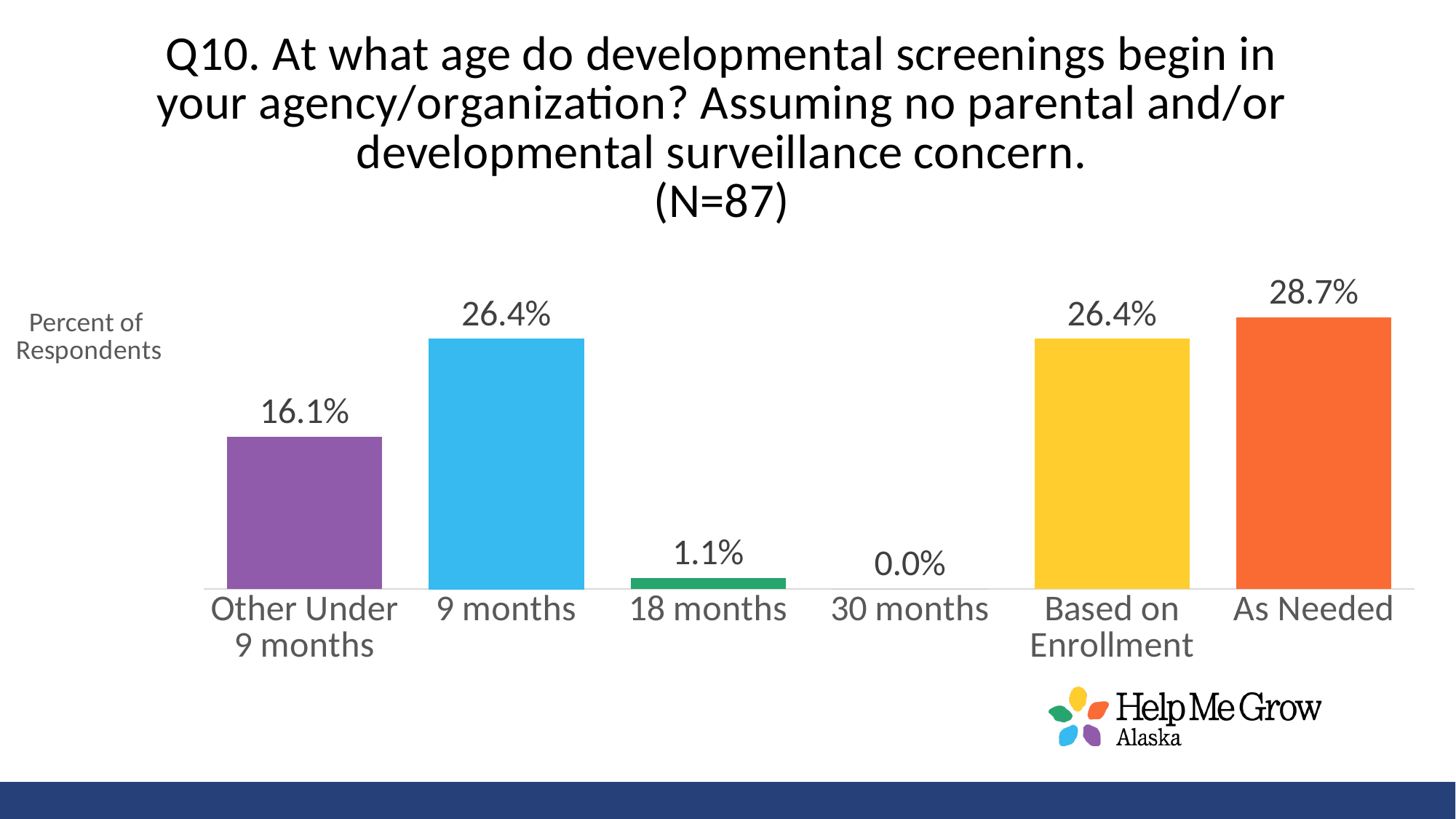
What percentage of respondents selected 'As Needed'? 28.7% How many categories are shown on the x axis? 6 What is the value shown for 18 months? 1.1% What is the sample size (N) stated in the chart title? 87 Which is larger: the value for 'Other Under 9 months' or the value for 18 months? Other Under 9 months What is the difference between the 9 months value and the 'Other Under 9 months' value? 10.3% What kind of chart is shown on the slide? Bar chart What percentage of respondents said developmental screenings begin at 9 months? 26.4% Which category has the lowest percentage of respondents? 30 months Which category has the highest percentage of respondents? As Needed What is the difference between the 'As Needed' value and the 'Based on Enrollment' value? 2.3% What is the value for the 'Other Under 9 months' category? 16.1%